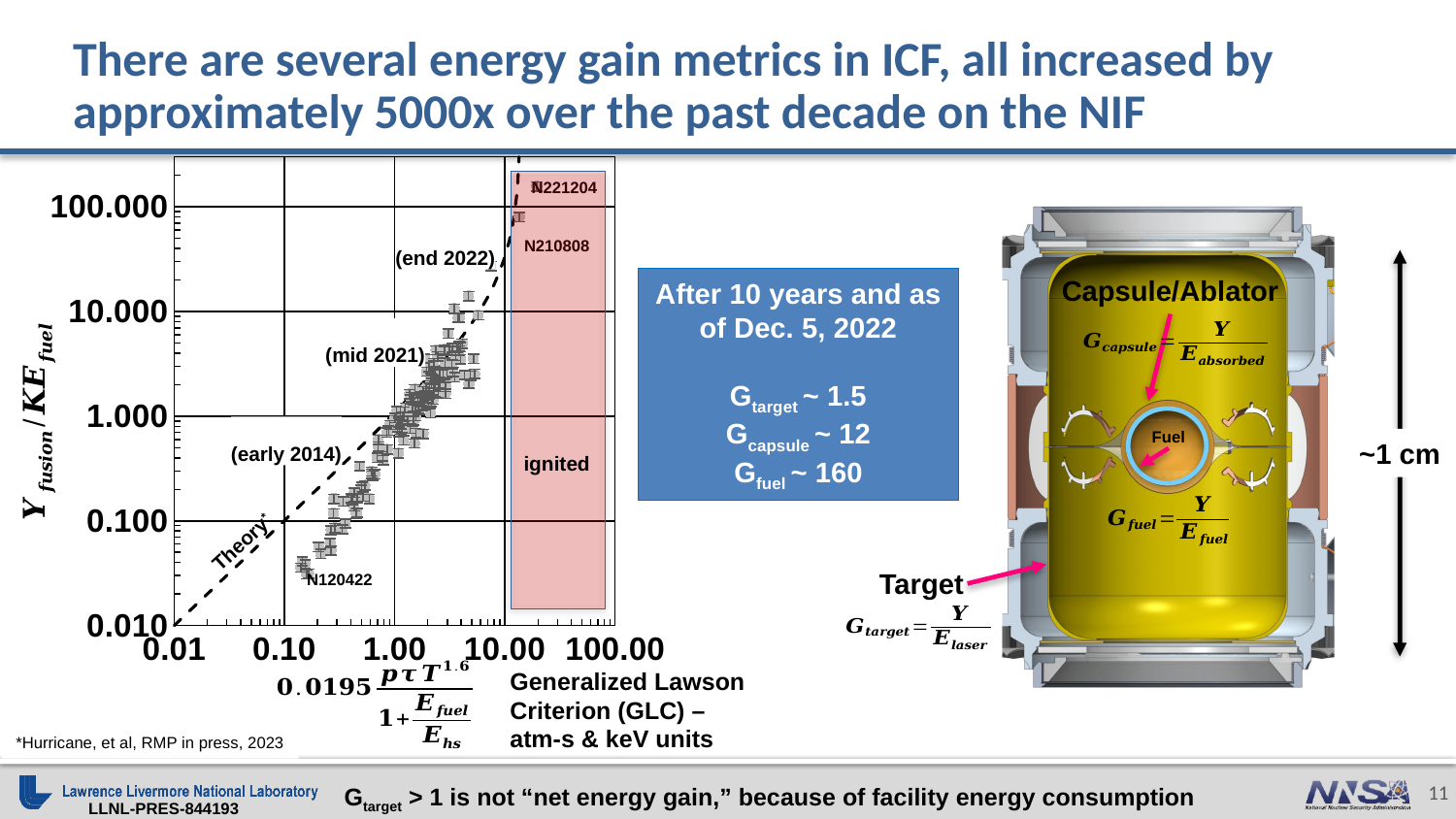
What is the dashed line on the scatter chart labeled? Theory What kind of chart is shown on the left of the slide? scatter chart On the scatter chart, is the Y_fusion/KE_fuel value for N210808 greater or less than 10.000? greater On the scatter chart, is the Y_fusion/KE_fuel value for N120422 greater or less than 0.100? less Which labeled shot on the scatter chart has the highest Y_fusion/KE_fuel value? N221204 On the scatter chart, which has the larger Y_fusion/KE_fuel value, N210808 or N120422? N210808 What label is given to the shaded region on the right side of the scatter chart? ignited How many individual shots are labeled by name (N-number) on the scatter chart? 3 On the scatter chart, is the Generalized Lawson Criterion value for N120422 greater or less than 1.00? less Which labeled shot on the scatter chart has the lowest Y_fusion/KE_fuel value? N120422 In the scatter chart, do the plotted values of Y_fusion/KE_fuel rise or fall as the Generalized Lawson Criterion increases along the x axis? rise